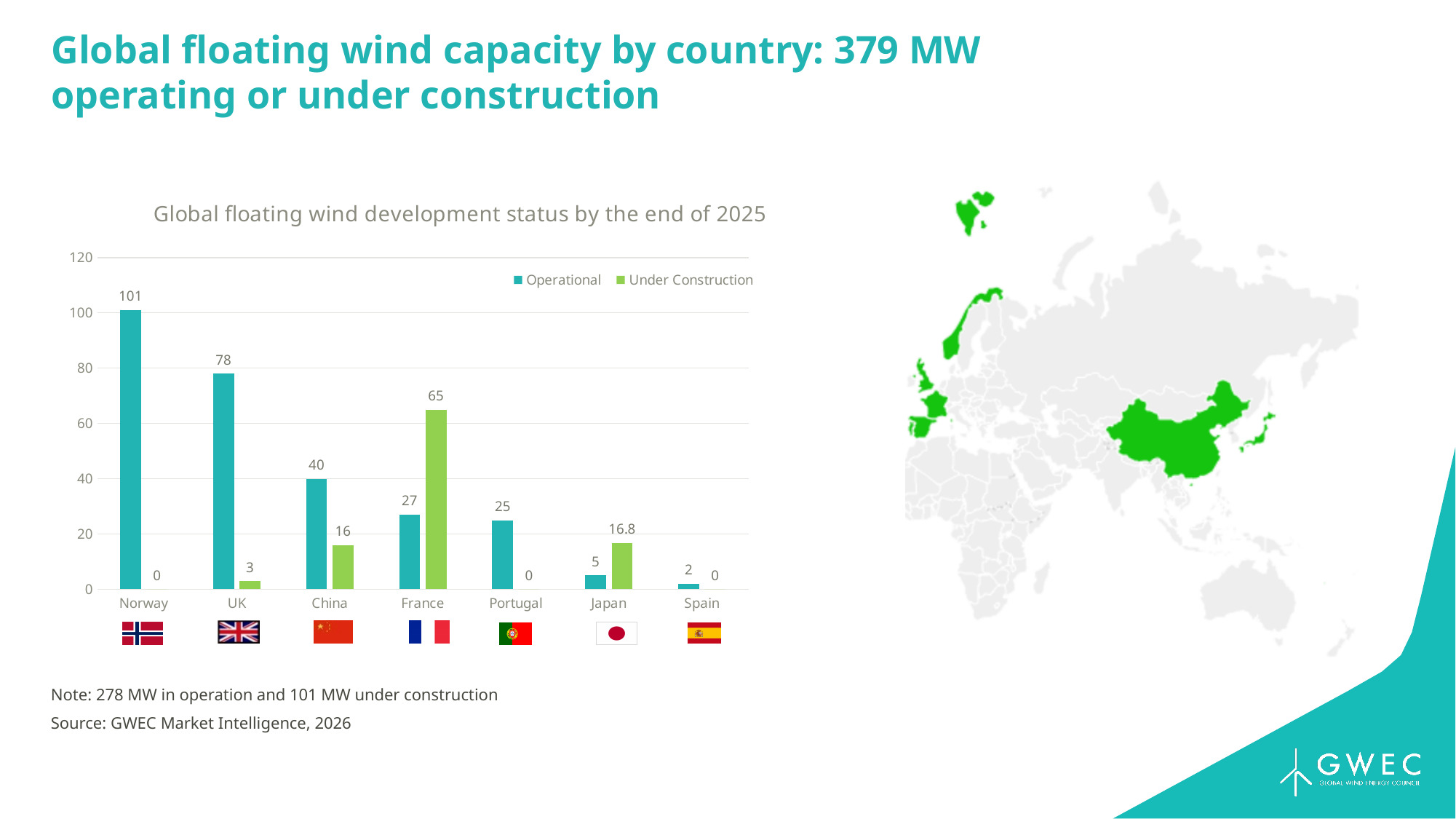
What is the difference between the Operational values for Norway and the UK? 23 What is the Operational value for Norway? 101 How many series does the legend list? 2 Is the Operational value for the UK greater or less than 60? greater How many countries are shown on the x axis? 7 What is the Under Construction value for Japan? 16.8 What is the Under Construction value for France? 65 Which country has the highest Operational value? Norway What kind of chart is shown? Bar chart What is the title of the chart? Global floating wind development status by the end of 2025 Which country has the lowest Operational value? Spain Which is larger for China: the Operational value or the Under Construction value? Operational